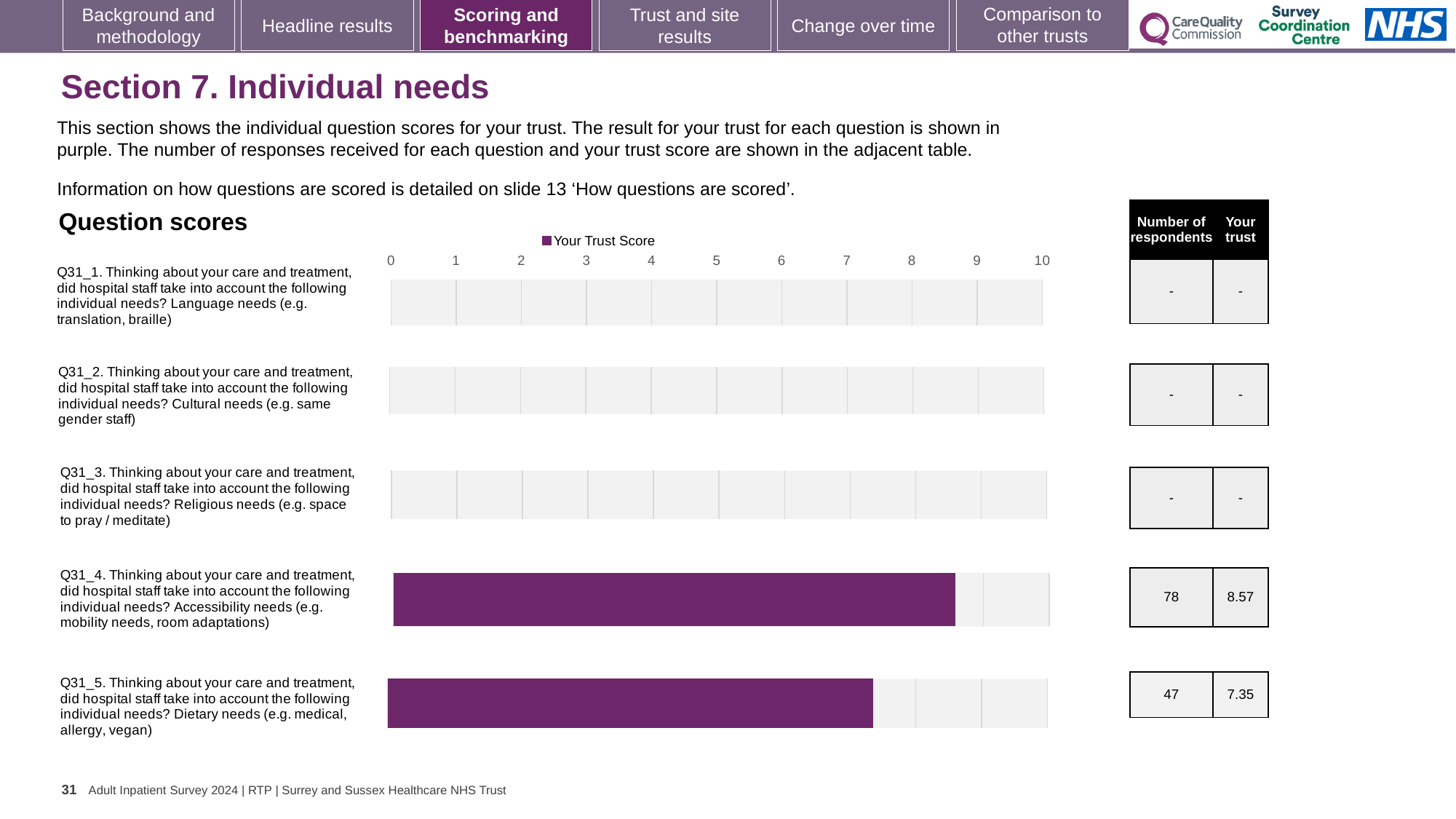
Is the trust score for Q31_4 (Accessibility needs) greater or less than 8? greater What is the trust score for Q31_5 (Dietary needs)? 7.35 What series does the chart legend list? Your Trust Score Which question has the highest trust score shown on the chart? Q31_4 (Accessibility needs) What is the trust score for Q31_4 (Accessibility needs)? 8.57 Is the trust score for Q31_5 (Dietary needs) greater or less than 8? less How many respondents answered Q31_5 (Dietary needs)? 47 How many questions are listed on the chart? 5 Which has a larger trust score, Q31_4 (Accessibility needs) or Q31_5 (Dietary needs)? Q31_4 (Accessibility needs) How many respondents answered Q31_4 (Accessibility needs)? 78 What type of chart is shown on the slide? Bar chart What is the difference between the trust scores for Q31_4 and Q31_5? 1.22